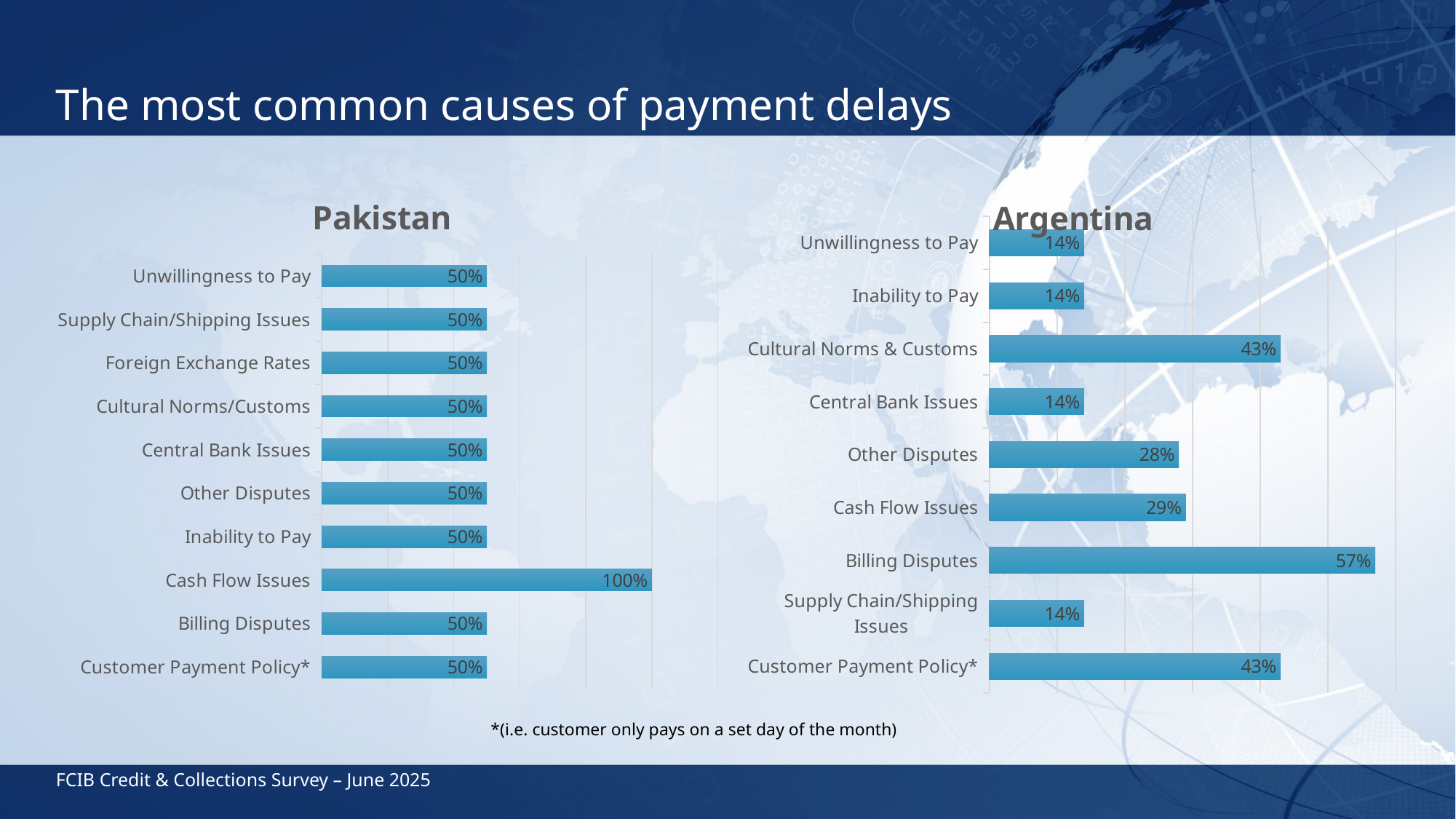
In the Argentina chart, what is the value for Cultural Norms & Customs? 43% In the Pakistan chart, what is the value for Cash Flow Issues? 100% In the Argentina chart, which is larger: Cash Flow Issues or Central Bank Issues? Cash Flow Issues In the Pakistan chart, how many categories are shown? 10 In the Argentina chart, what is the difference between Billing Disputes and Other Disputes? 29% What type of chart is the Argentina chart? Bar chart In the Argentina chart, how many categories are shown? 9 In the Pakistan chart, which category has the highest value? Cash Flow Issues In the Argentina chart, which category has the highest value? Billing Disputes In the Pakistan chart, what is the value for Billing Disputes? 50% In the Pakistan chart, what is the difference between Cash Flow Issues and Unwillingness to Pay? 50% In the Argentina chart, what is the value for Billing Disputes? 57%